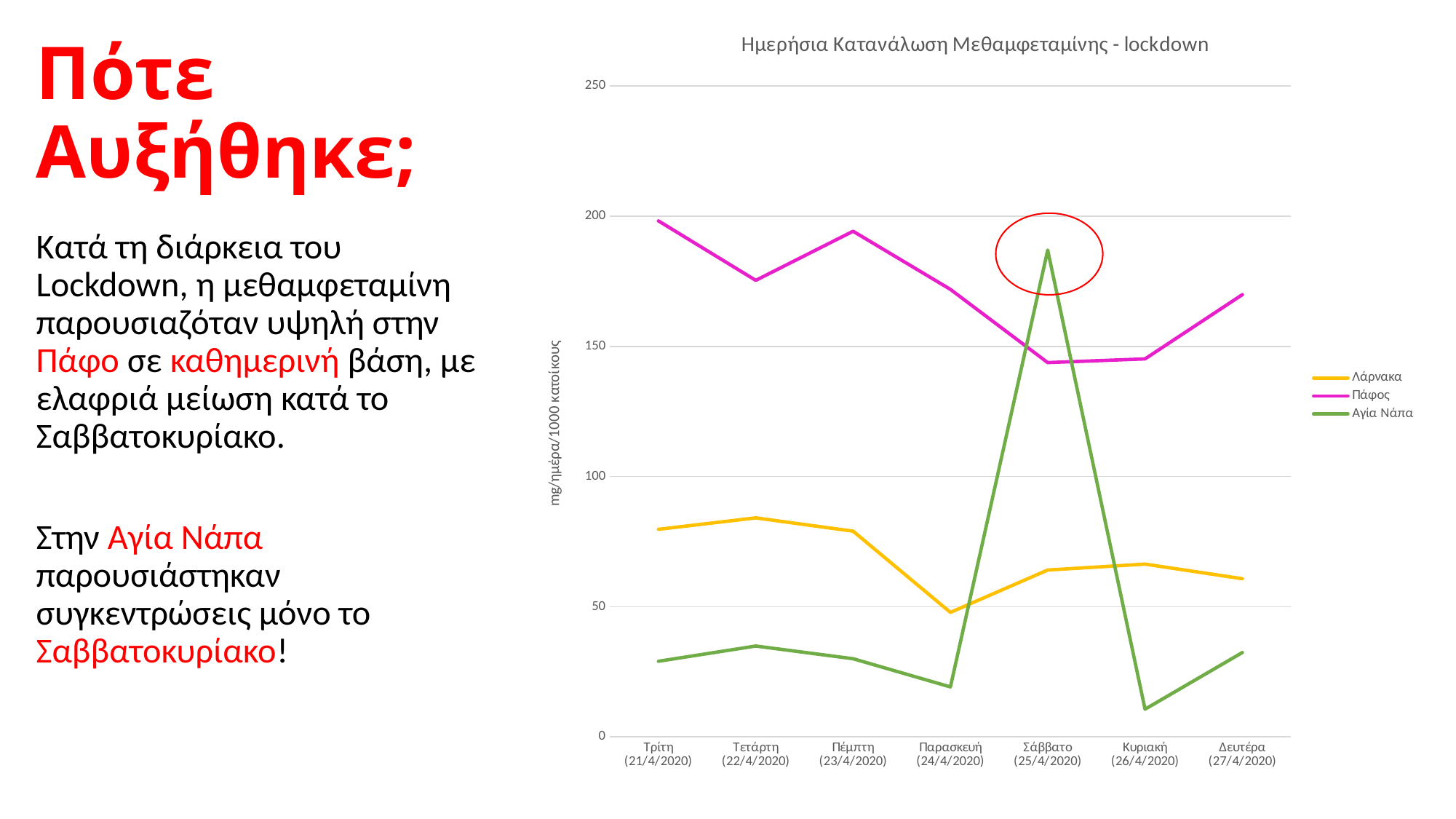
Is the value for Πάφος on Τρίτη (21/4/2020) greater or less than 150? greater How many series does the legend list? 3 Which series has the higher value on Κυριακή (26/4/2020), Πάφος or Λάρνακα? Πάφος Does the value for Λάρνακα rise or fall from Τετάρτη (22/4/2020) to Παρασκευή (24/4/2020)? fall What kind of chart is shown on the slide? line chart What is the label of the y axis? mg/ημέρα/1000 κατοίκους Is the value for Λάρνακα on Τετάρτη (22/4/2020) greater or less than 100? less How many days are plotted along the x axis? 7 On which day does Αγία Νάπα reach its highest value? Σάββατο (25/4/2020) What is the title of the chart? Ημερήσια Κατανάλωση Μεθαμφεταμίνης - lockdown Is the value for Αγία Νάπα on Σάββατο (25/4/2020) greater or less than 150? greater On which day does Αγία Νάπα have its lowest value? Κυριακή (26/4/2020)